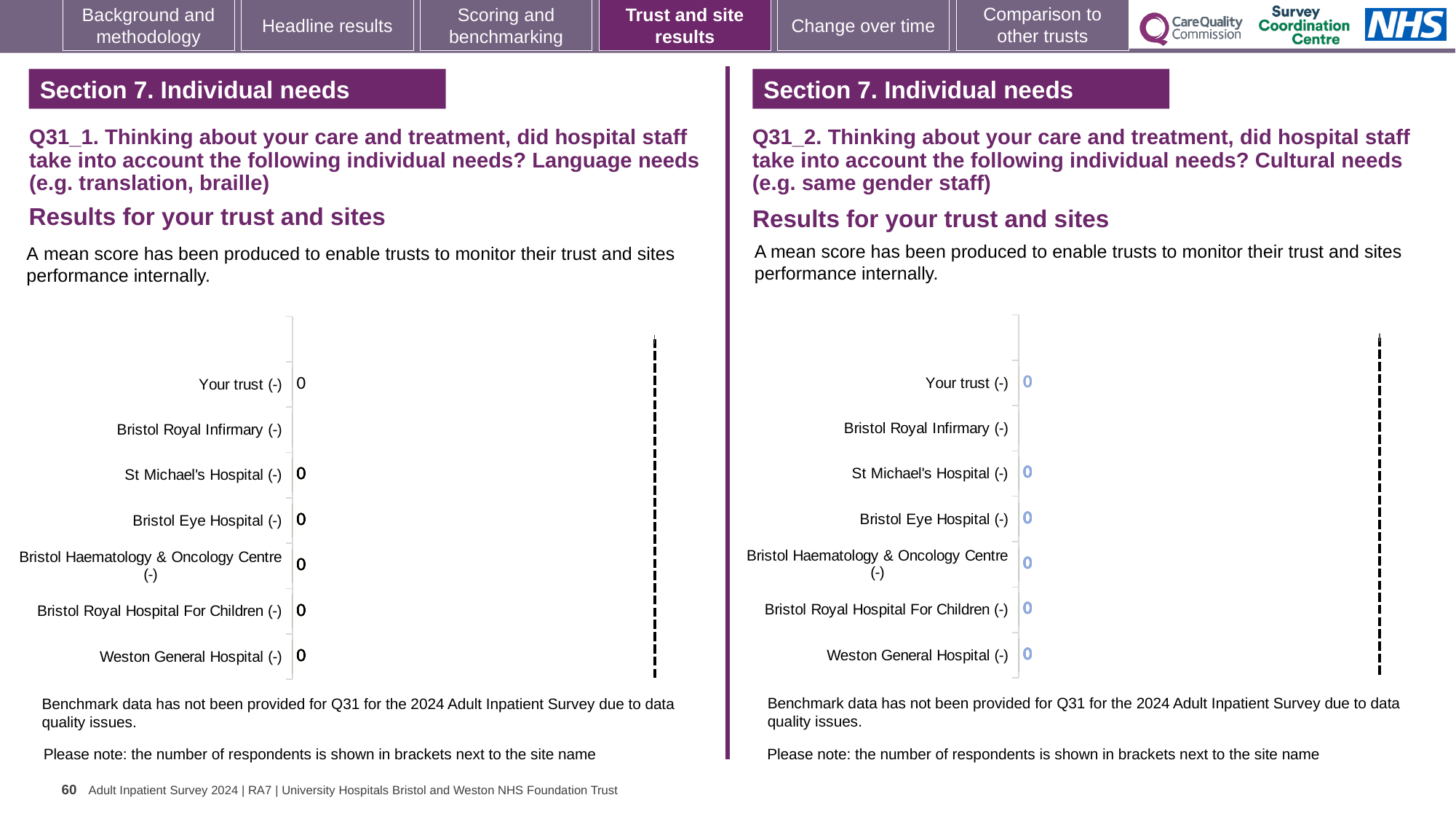
Which individual need does the question for the right chart (Q31_2) ask about? Cultural needs (e.g. same gender staff) On the right chart (Q31_2, Cultural needs), what value is shown for St Michael's Hospital? 0 On the left chart (Q31_1, Language needs), what value is shown for Your trust? 0 On the right chart (Q31_2, Cultural needs), what value is shown for Your trust? 0 On the left chart (Q31_1, Language needs), what is the difference between the values for Your trust and Weston General Hospital? 0 On the left chart (Q31_1, Language needs), what value is shown for Weston General Hospital? 0 On the right chart (Q31_2, Cultural needs), what value is shown for Bristol Royal Hospital For Children? 0 On the left chart (Q31_1, Language needs), what value is shown for Bristol Eye Hospital? 0 How many categories (trust and sites) are listed on the right chart (Q31_2, Cultural needs)? 7 Which site on the right chart (Q31_2, Cultural needs) has no data label shown next to it? Bristol Royal Infirmary What kind of chart is used on the left side of the slide for Q31_1? Bar chart How many categories (trust and sites) are listed on the left chart (Q31_1, Language needs)? 7